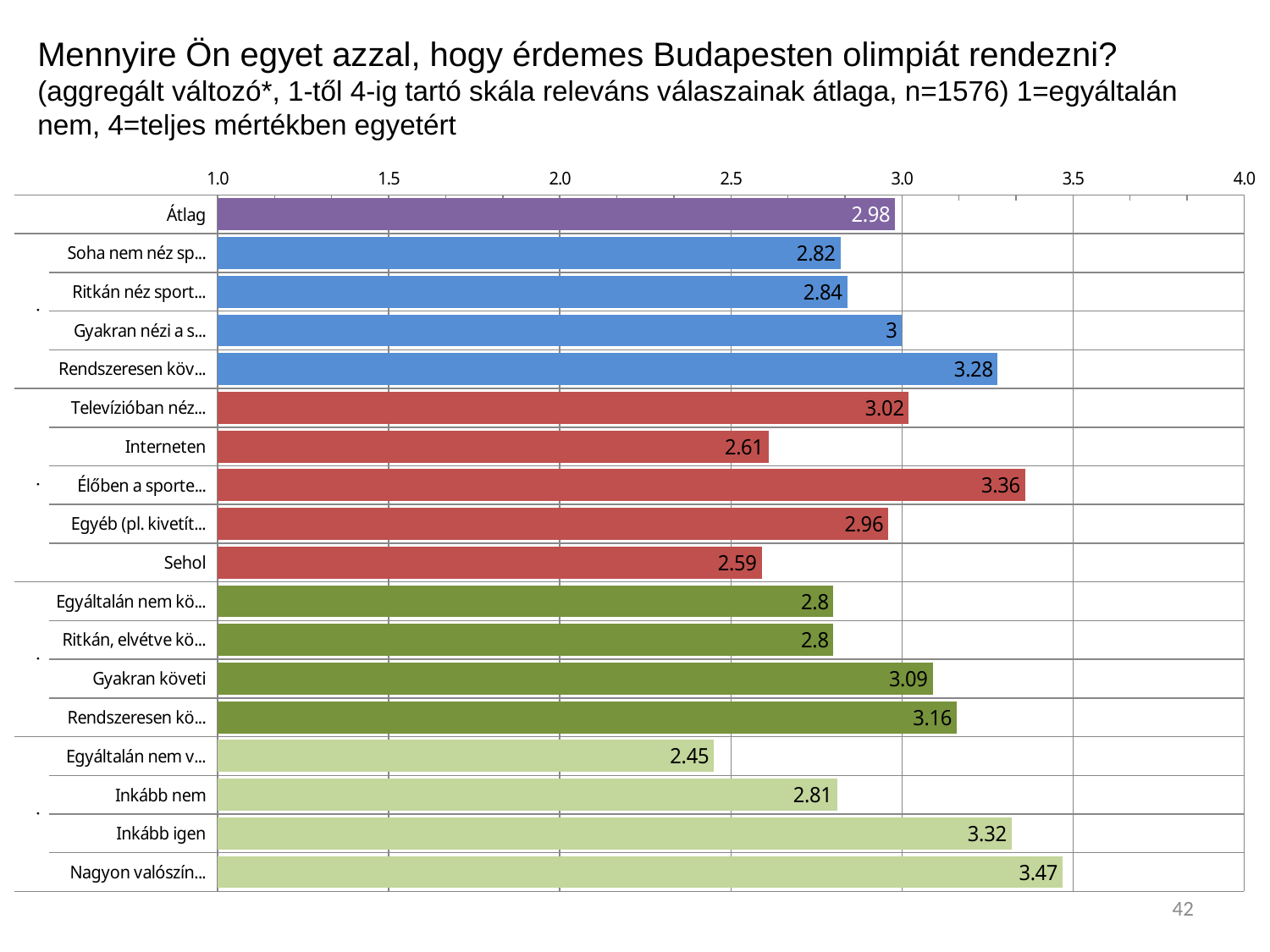
What is the lowest value shown on the chart? 2.45 Is the value for Gyakran követi greater or less than 3.0? greater How many bars are plotted on the chart? 18 What is the difference between the values for Inkább igen and Inkább nem? 0.51 What is the value for Gyakran követi? 3.09 What is the value for Sehol? 2.59 What is the value for Átlag? 2.98 What is the value for Interneten? 2.61 What is the value for Inkább igen? 3.32 Which has a larger value, Interneten or Sehol? Interneten What kind of chart is shown on the slide? bar chart What is the highest value shown on the chart? 3.47